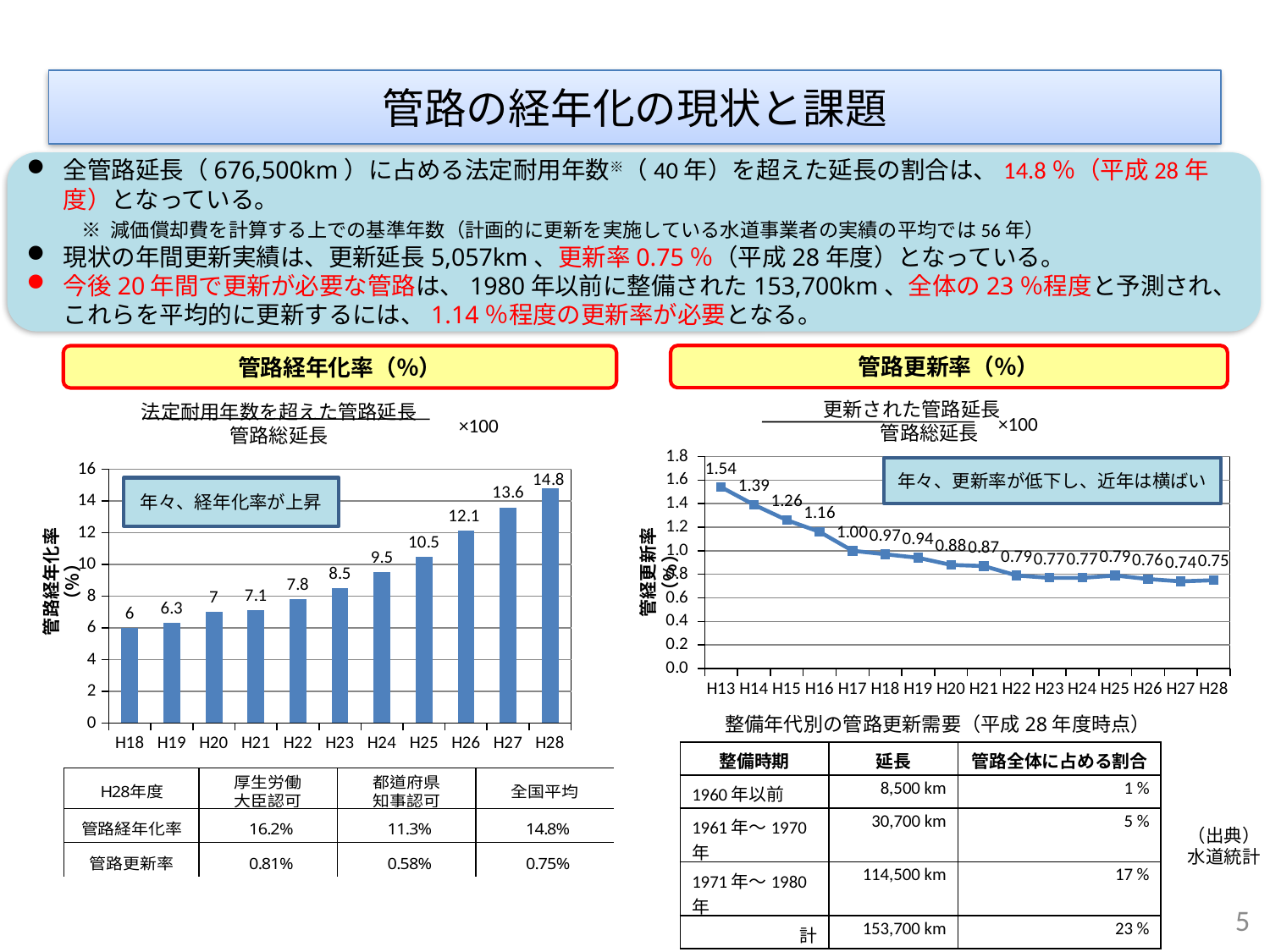
What kind of chart is the 管路更新率（%） chart? line chart In the 管路経年化率（%） chart, what is the value for H22? 7.8 In the 管路経年化率（%） chart, which year has the lowest value? H18 What kind of chart is the 管路経年化率（%） chart? bar chart In the 管路経年化率（%） chart, what is the difference between the H28 and H18 values? 8.8 In the 管路経年化率（%） chart, how many years are shown on the x axis? 11 In the 管路更新率（%） chart, which is larger, the value for H17 or the value for H21? H17 In the 管路経年化率（%） chart, do the values rise or fall from H18 to H28? rise In the 管路経年化率（%） chart, what is the value for H28? 14.8 In the 管路更新率（%） chart, what is the value for H28? 0.75 In the 管路更新率（%） chart, which year has the highest value? H13 In the 管路更新率（%） chart, what is the value for H13? 1.54